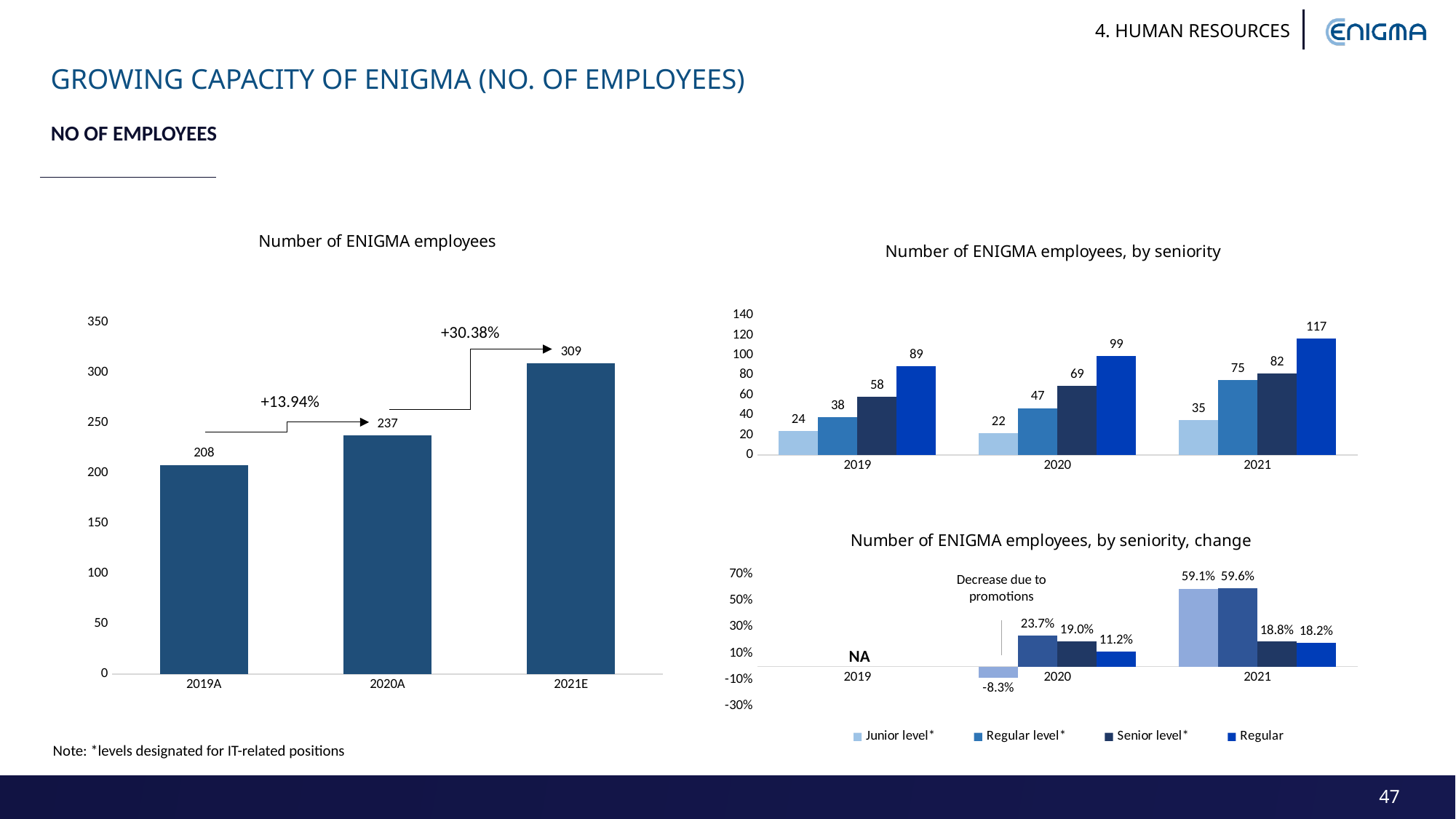
In the 'Number of ENIGMA employees, by seniority' chart, what is the value for Senior level in 2020? 69 In the 'Number of ENIGMA employees' chart, what percentage growth is shown between 2020A and 2021E? +30.38% In the 'Number of ENIGMA employees, by seniority, change' chart, what is the value for Junior level in 2020? -8.3% How many series does the legend at the bottom of the slide list? 4 What kind of chart is 'Number of ENIGMA employees'? bar chart In the 'Number of ENIGMA employees, by seniority' chart, which year has the highest Junior level value? 2021 In the 'Number of ENIGMA employees' chart, what is the value for 2020A? 237 In the 'Number of ENIGMA employees' chart, do the values rise or fall from 2019A to 2021E? rise In the 'Number of ENIGMA employees, by seniority, change' chart, which is larger in 2021: Regular level or Senior level? Regular level In the 'Number of ENIGMA employees, by seniority' chart, what is the difference between the Regular values for 2021 and 2019? 28 In the 'Number of ENIGMA employees' chart, what is the value for 2021E? 309 In the 'Number of ENIGMA employees' chart, what is the difference between the 2021E and 2019A values? 101